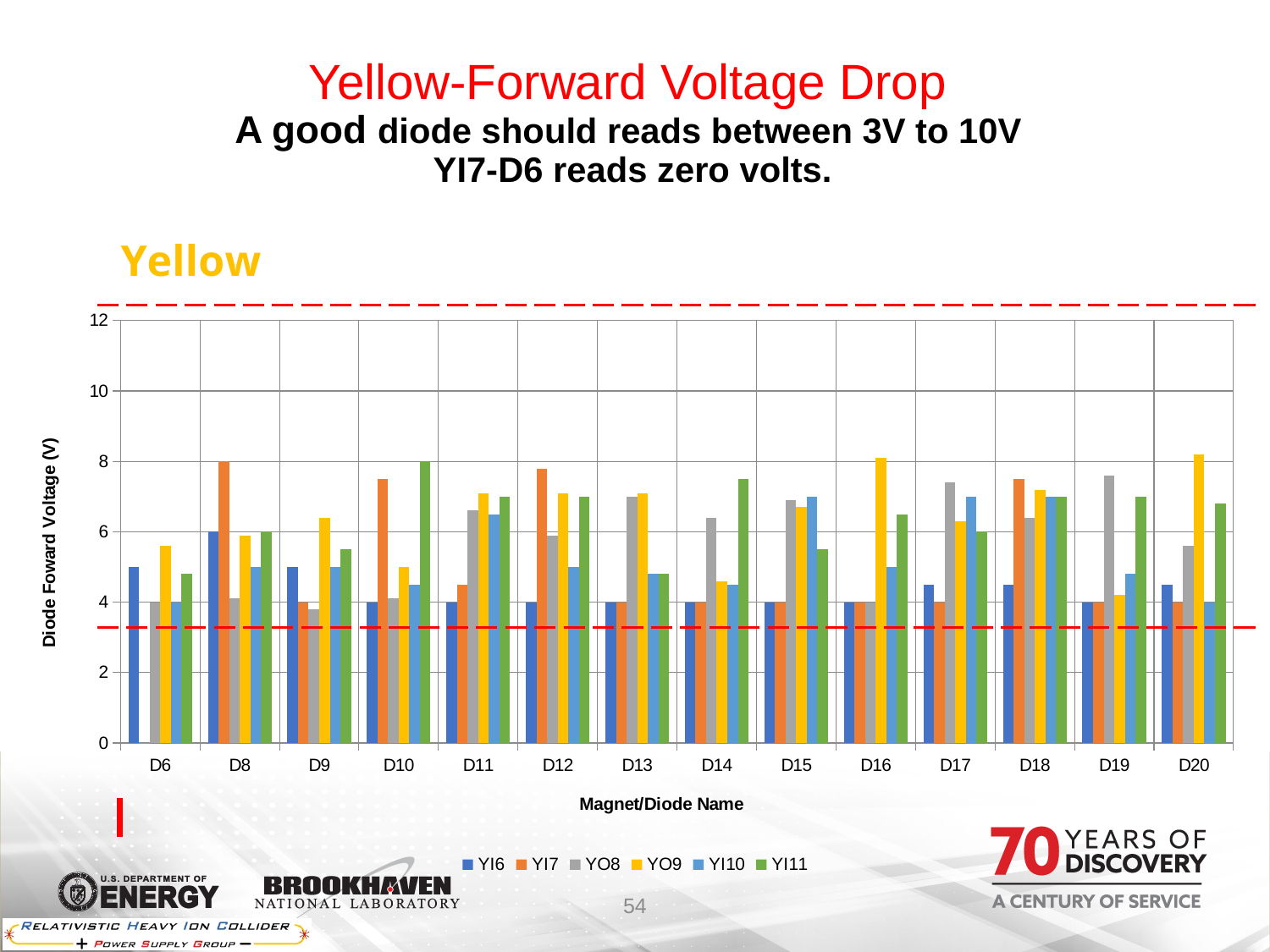
What is the diode forward voltage for YI7 at D8? 8 Is the value for YO9 at D14 greater or less than 6? less How many series does the legend list? 6 Which series has the highest value at D8? YI7 What is the diode forward voltage for YI11 at D17? 6 What kind of chart is shown on the slide? bar chart What is the diode forward voltage for YI6 at D8? 6 What is the title of the x axis? Magnet/Diode Name How many magnet/diode categories are shown on the x axis? 14 What is the diode forward voltage for YI7 at D6? 0 At D16, which is larger, the value for YO9 or the value for YI11? YO9 Which series has the lowest value at D6? YI7